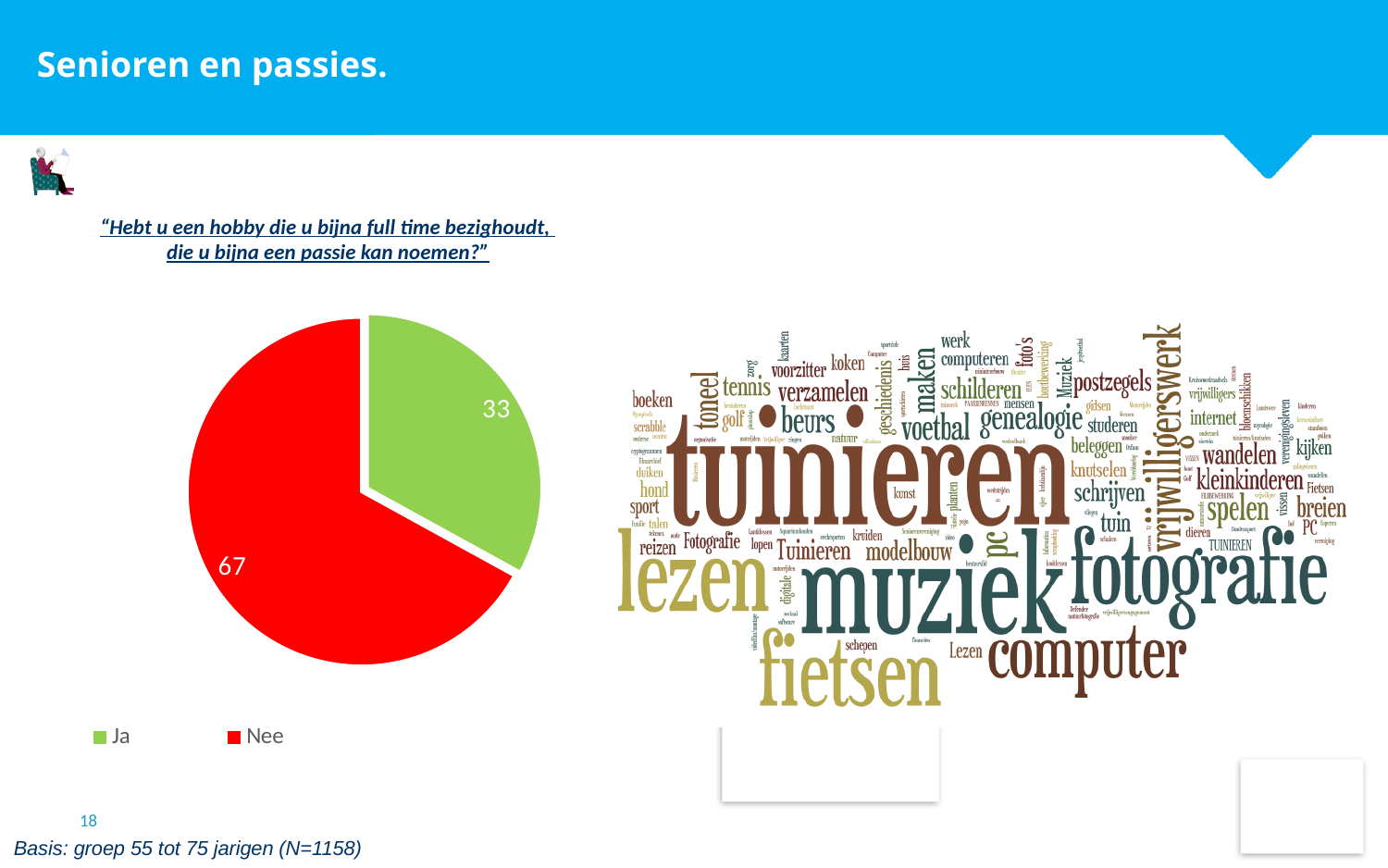
How many slices does the pie chart have? 2 What colour is the "Nee" slice in the pie chart? red What is the value for "Ja" in the pie chart? 33 How many entries does the legend of the pie chart list? 2 What kind of chart is shown on the slide? pie chart Which slice of the pie chart is the smallest? Ja What is the difference between the values for "Nee" and "Ja" in the pie chart? 34 What colour is the "Ja" slice in the pie chart? green Which is larger in the pie chart, "Ja" or "Nee"? Nee What is the value for "Nee" in the pie chart? 67 Which slice of the pie chart is the largest? Nee